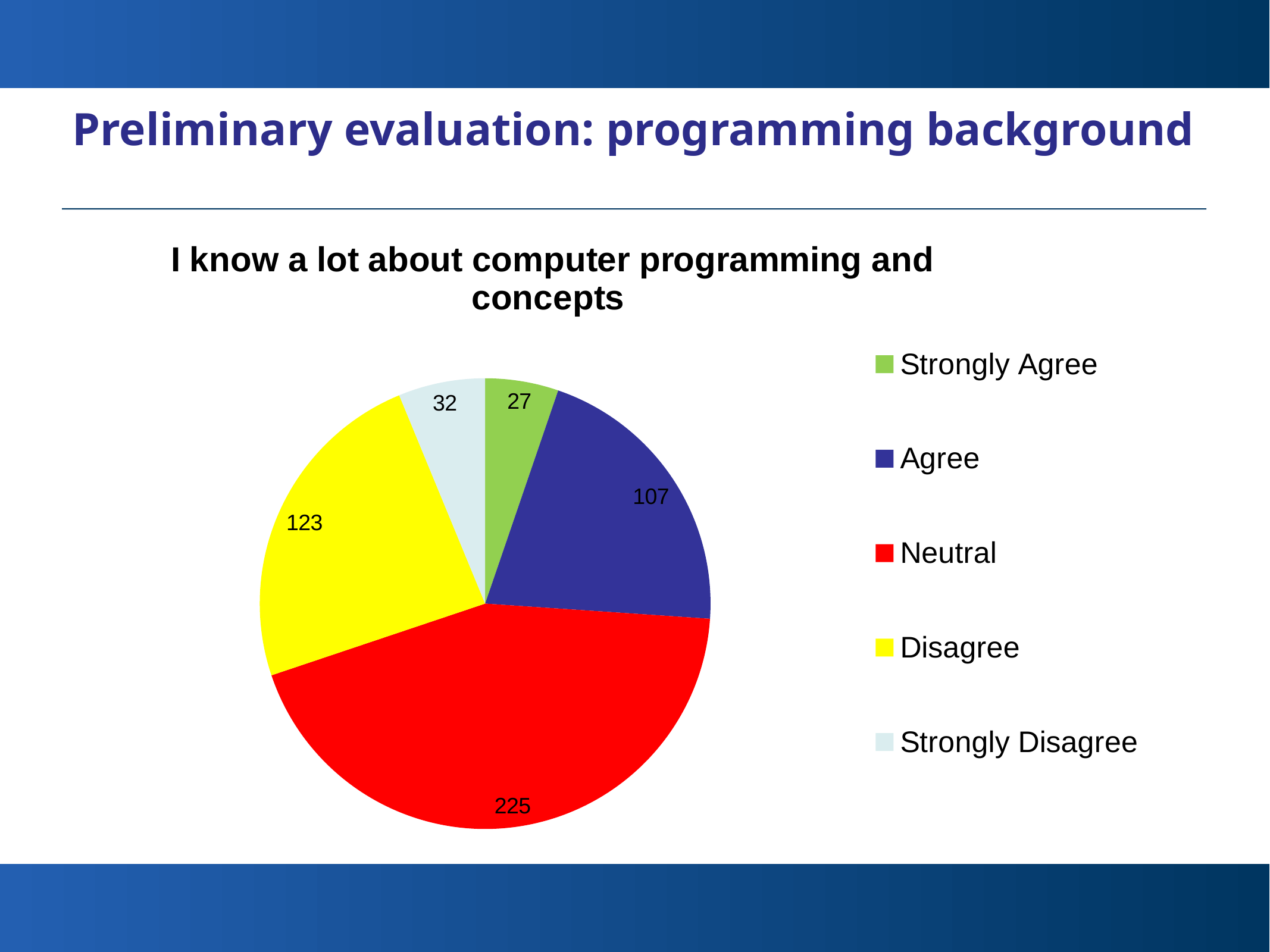
Which category has the smallest slice? Strongly Agree How many categories does the pie chart have? 5 What is the value for Neutral? 225 What is the total of all slices in the pie chart? 514 Which is larger, Agree or Disagree? Disagree What is the value for Strongly Agree? 27 What type of chart is shown on the slide? pie chart What is the value for Strongly Disagree? 32 What is the value for Agree? 107 What is the difference between the Neutral and Disagree values? 102 Which category has the largest slice? Neutral What is the title of the chart? I know a lot about computer programming and concepts